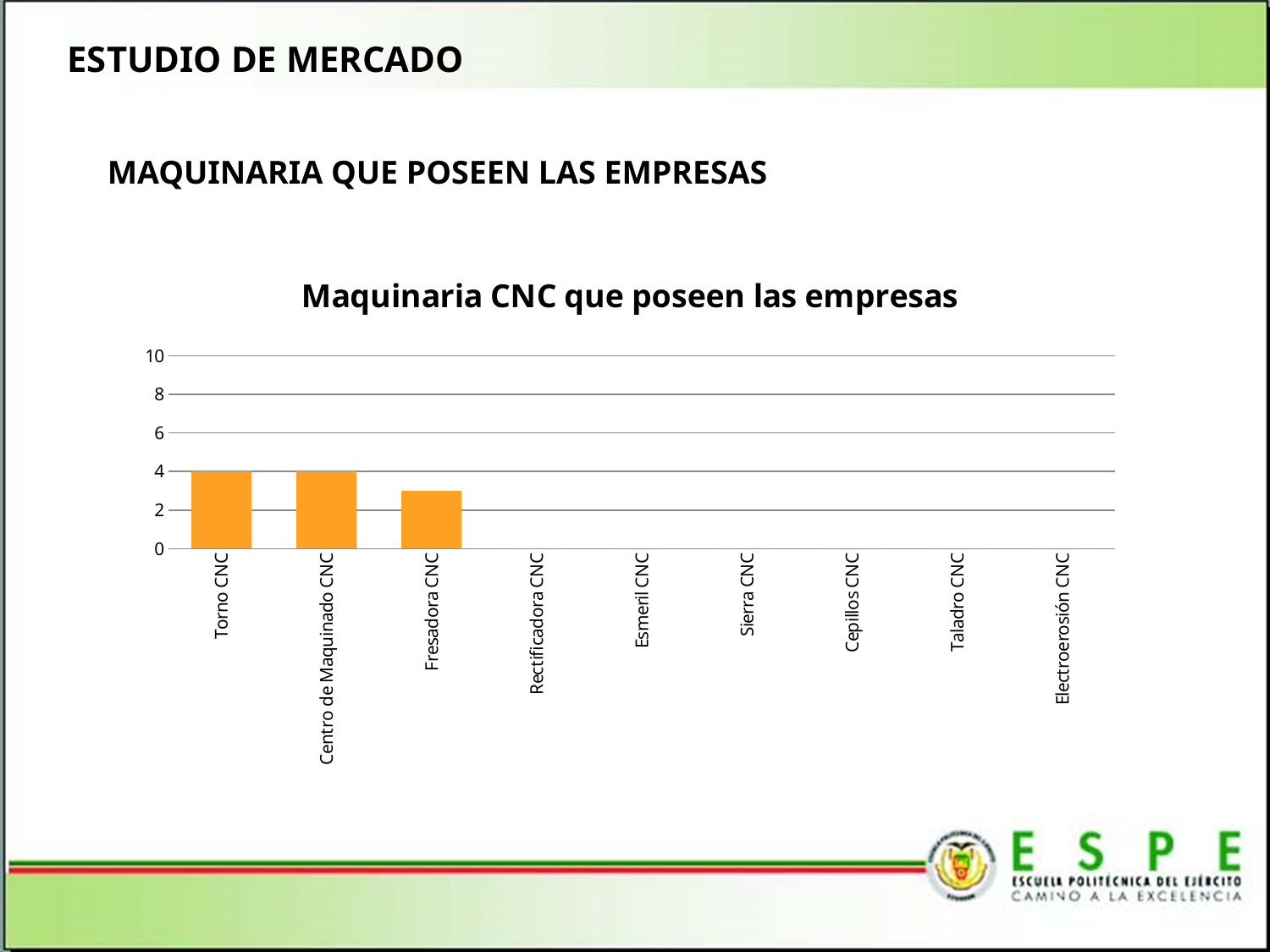
What is the value for Centro de Maquinado CNC? 4 What is the title of the chart? Maquinaria CNC que poseen las empresas Which is larger, the value for Torno CNC or the value for Fresadora CNC? Torno CNC What colour are the bars in the chart? orange Is the value for Fresadora CNC greater or less than 4? less How many categories are shown on the x axis of the chart? 9 What type of chart is shown on the slide? bar chart Is the value for Fresadora CNC greater or less than 2? greater What is the value for Torno CNC? 4 What is the value for Rectificadora CNC? 0 What is the value for Electroerosión CNC? 0 Which is larger, the value for Centro de Maquinado CNC or the value for Sierra CNC? Centro de Maquinado CNC